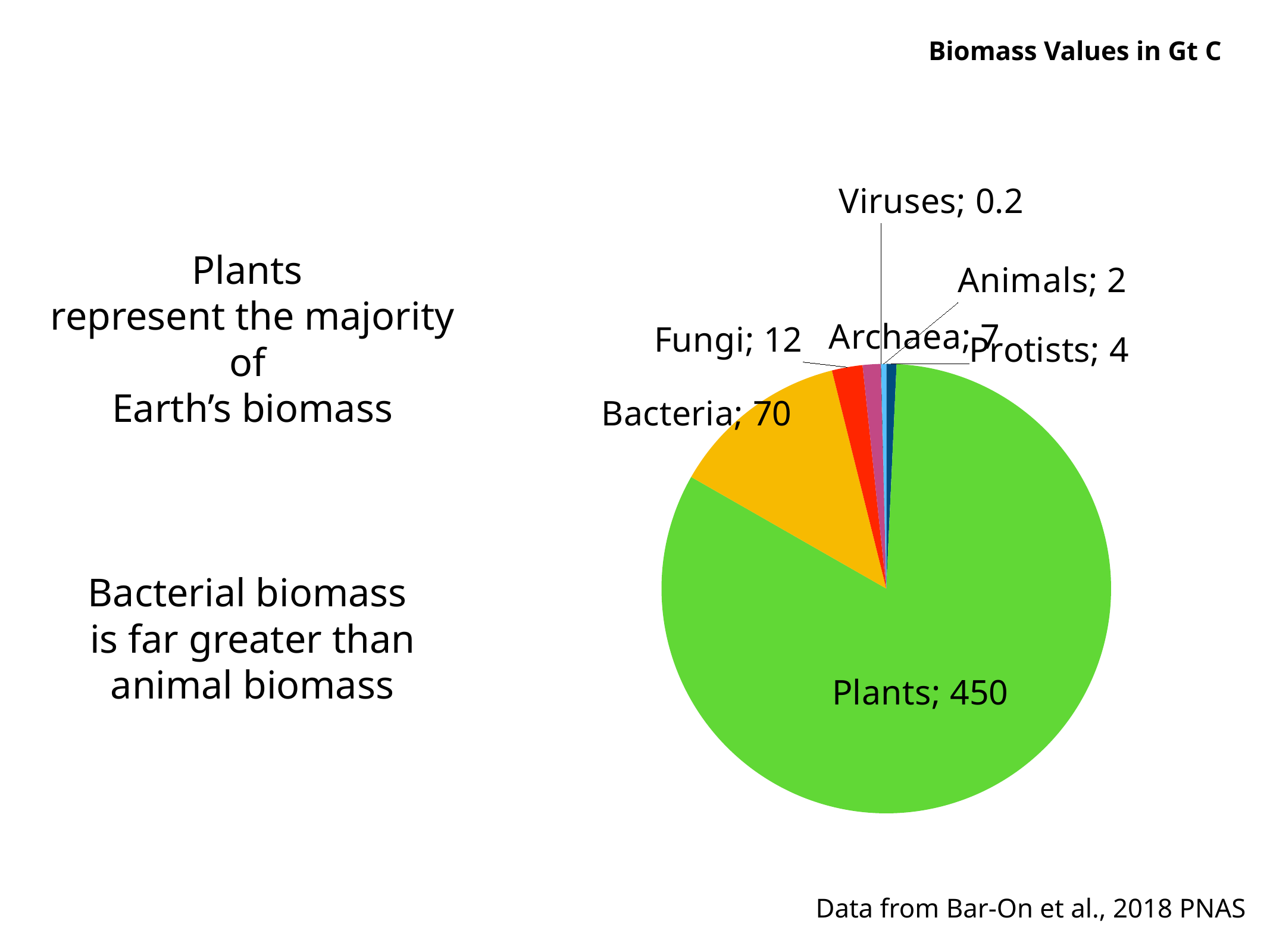
What kind of chart is shown on the slide? Pie chart Which category has the smallest biomass value? Viruses What is the biomass value for Archaea? 7 What is the biomass value for Bacteria? 70 What is the difference between the biomass values for Plants and Bacteria? 380 Which category has the largest biomass value? Plants What is the title of the chart? Biomass Values in Gt C What is the biomass value for Viruses? 0.2 What is the difference between the biomass values for Bacteria and Animals? 68 What is the biomass value for Plants? 450 How many categories are shown in the pie chart? 7 Which has a larger biomass value, Fungi or Protists? Fungi